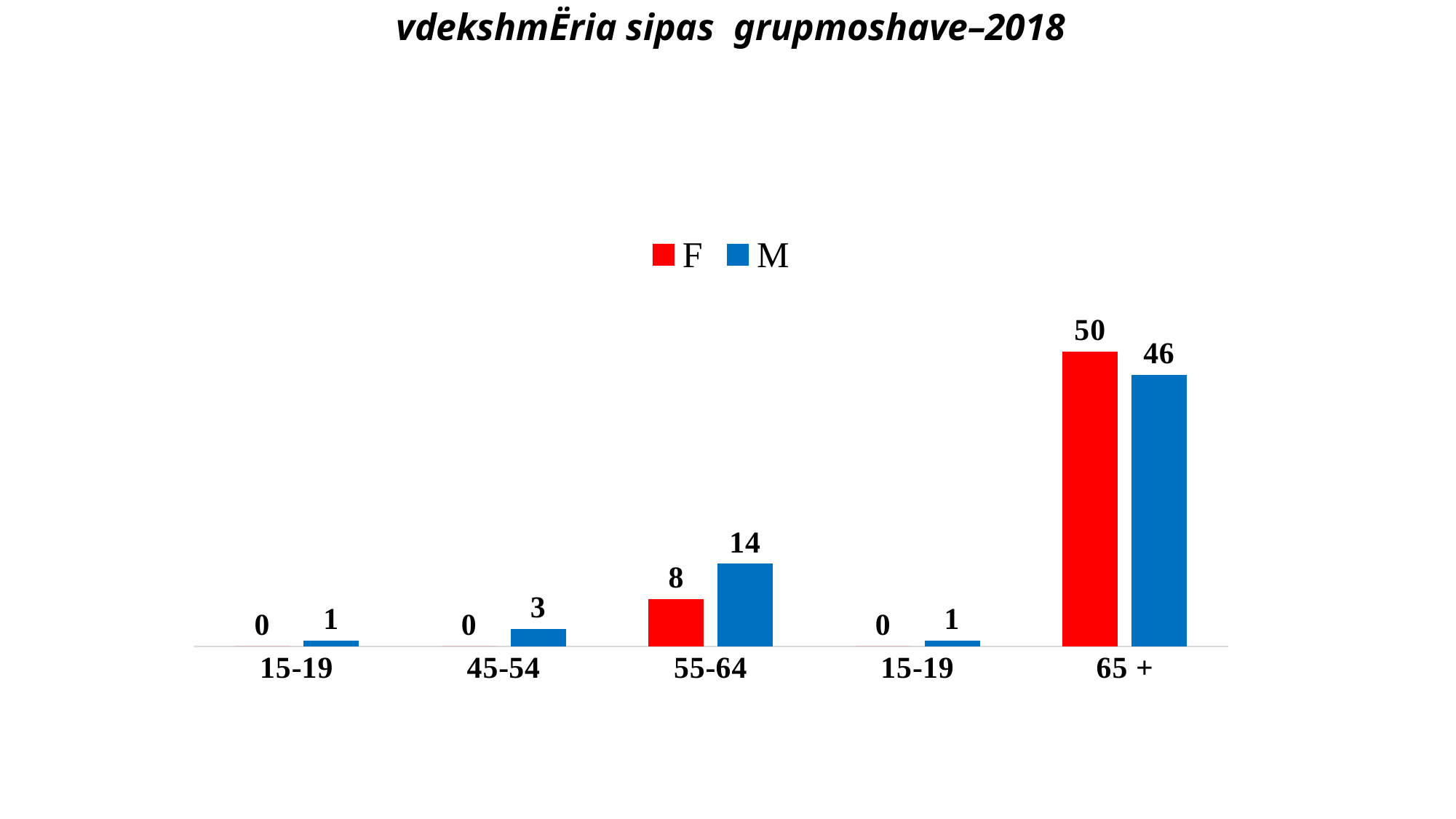
In the 55-64 age group, which series has the larger value, F or M? M What is the value for F in the 55-64 age group? 8 How many series does the legend list? 2 What is the value for M in the 55-64 age group? 14 Which age group has the highest value for M? 65 + What is the value for M in the 45-54 age group? 3 What is the value for F in the 65 + age group? 50 What is the difference between the M and F values in the 55-64 age group? 6 In the 65 + age group, which series has the larger value, F or M? F Which age group has the highest value for F? 65 + What type of chart is shown on the slide? Bar chart What is the difference between the F and M values in the 65 + age group? 4